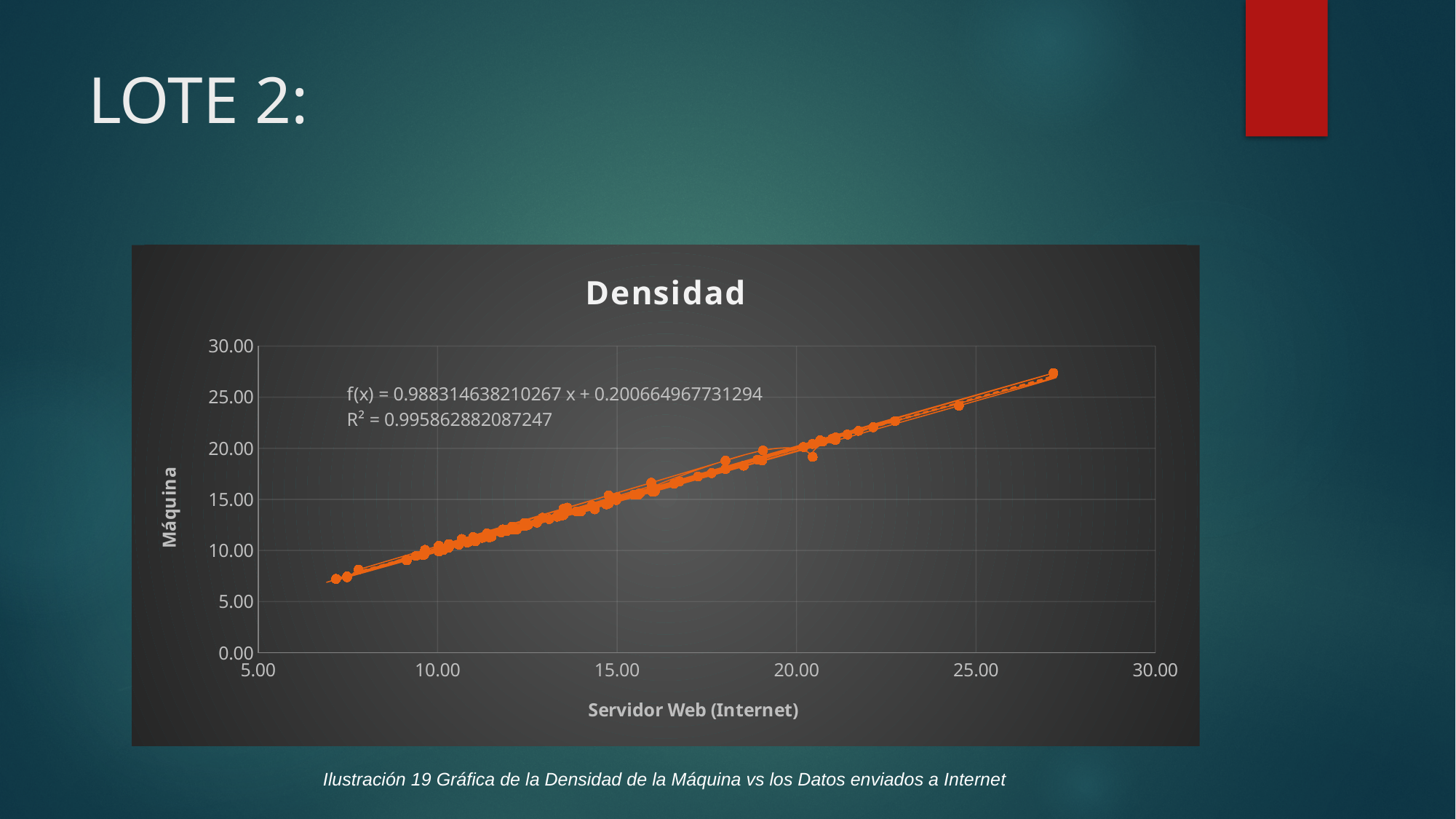
Is the Máquina value of the highest plotted point greater or less than 25.00? greater What is the minimum value shown on the x axis of the chart? 5.00 What is the label of the x axis of the chart? Servidor Web (Internet) What is the title of the chart? Densidad Is the Servidor Web (Internet) value of the rightmost plotted point greater or less than 25.00? greater Is the Máquina value of the lowest plotted point greater or less than 10.00? less What R² value is printed on the chart? 0.995862882087247 Do the plotted values rise or fall as the x axis increases? rise What is the slope of the trendline equation printed on the chart? 0.988314638210267 What kind of chart is shown on the slide? scatter chart What is the intercept of the trendline equation printed on the chart? 0.200664967731294 What is the maximum value shown on the y axis of the chart? 30.00